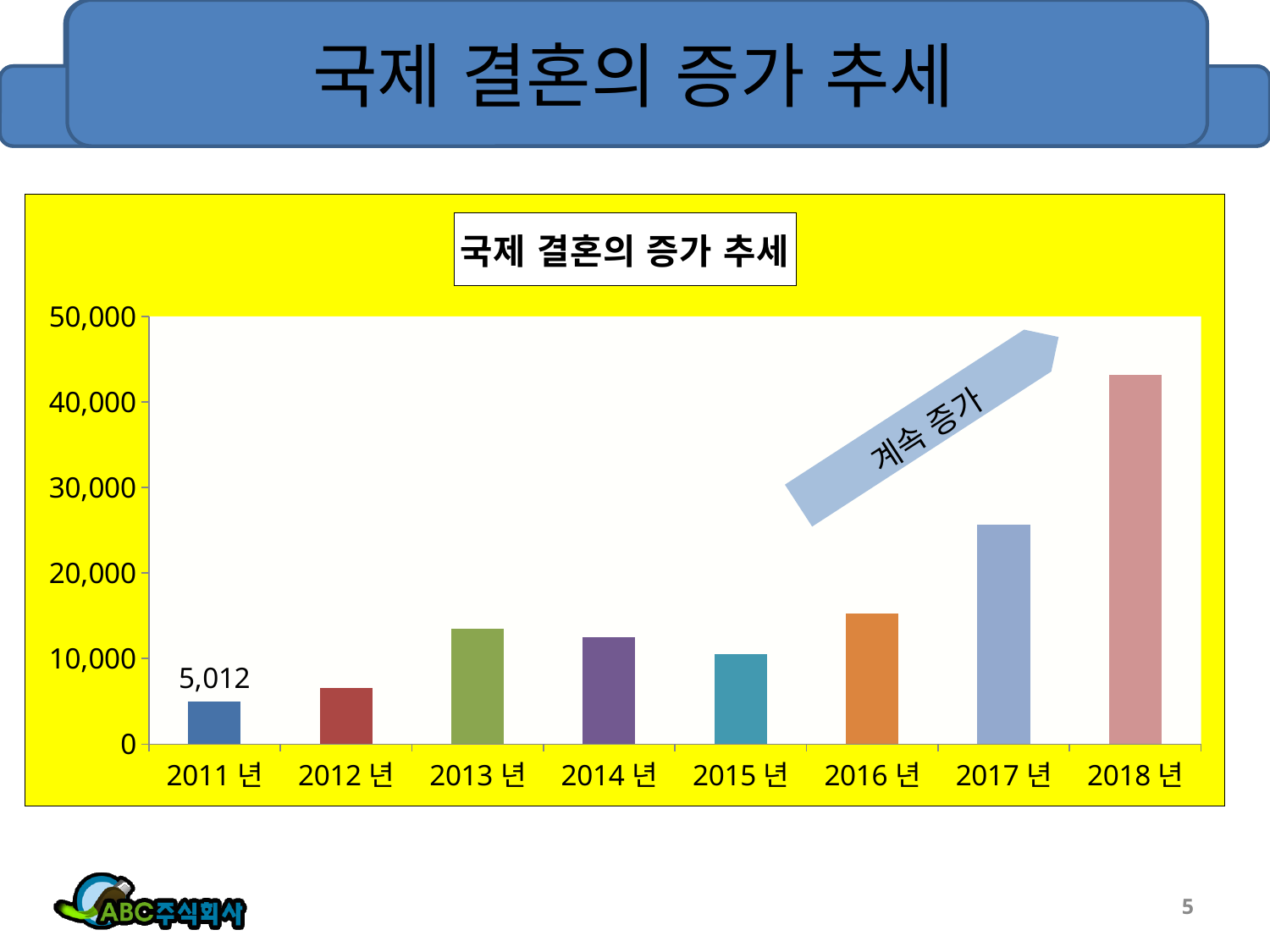
Which year has the lowest bar? 2011 년 Which year has the highest bar? 2018 년 What is the title of the chart? 국제 결혼의 증가 추세 Is the value for 2016 년 greater or less than 20,000? less Which is larger, the value for 2017 년 or the value for 2016 년? 2017 년 Is the value for 2018 년 greater or less than 40,000? greater What kind of chart is this? Bar chart How many years are shown on the x axis? 8 Do the values generally rise or fall from 2011 년 to 2018 년? Rise Is the value for 2017 년 greater or less than 20,000? greater What is the value for 2011 년? 5,012